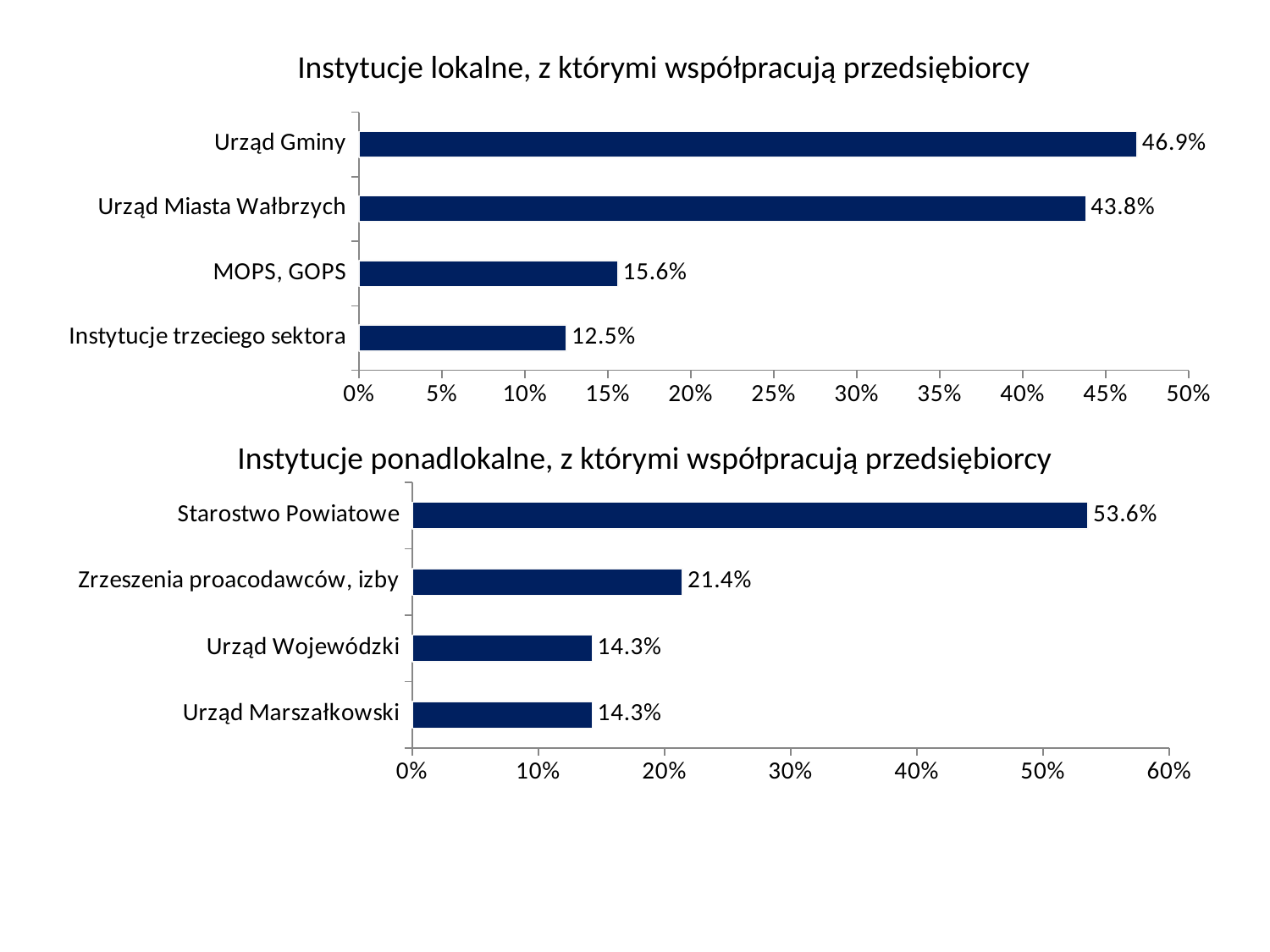
In the chart 'Instytucje lokalne, z którymi współpracują przedsiębiorcy', what is the value for MOPS, GOPS? 15.6% In the chart 'Instytucje ponadlokalne, z którymi współpracują przedsiębiorcy', what is the difference between Starostwo Powiatowe and Zrzeszenia proacodawców, izby? 32.2% In the chart 'Instytucje ponadlokalne, z którymi współpracują przedsiębiorcy', what is the value for Starostwo Powiatowe? 53.6% In the chart 'Instytucje ponadlokalne, z którymi współpracują przedsiębiorcy', which is larger: Starostwo Powiatowe or Urząd Wojewódzki? Starostwo Powiatowe What type of chart is the bottom chart on the slide? Bar chart In the chart 'Instytucje lokalne, z którymi współpracują przedsiębiorcy', how many categories are shown? 4 What is the title of the top chart on the slide? Instytucje lokalne, z którymi współpracują przedsiębiorcy In the chart 'Instytucje lokalne, z którymi współpracują przedsiębiorcy', which category has the lowest value? Instytucje trzeciego sektora In the chart 'Instytucje lokalne, z którymi współpracują przedsiębiorcy', what is the value for Urząd Gminy? 46.9% In the chart 'Instytucje lokalne, z którymi współpracują przedsiębiorcy', what is the difference between Urząd Gminy and Urząd Miasta Wałbrzych? 3.1% In the chart 'Instytucje ponadlokalne, z którymi współpracują przedsiębiorcy', what is the value for Zrzeszenia proacodawców, izby? 21.4% In the chart 'Instytucje ponadlokalne, z którymi współpracują przedsiębiorcy', which category has the highest value? Starostwo Powiatowe